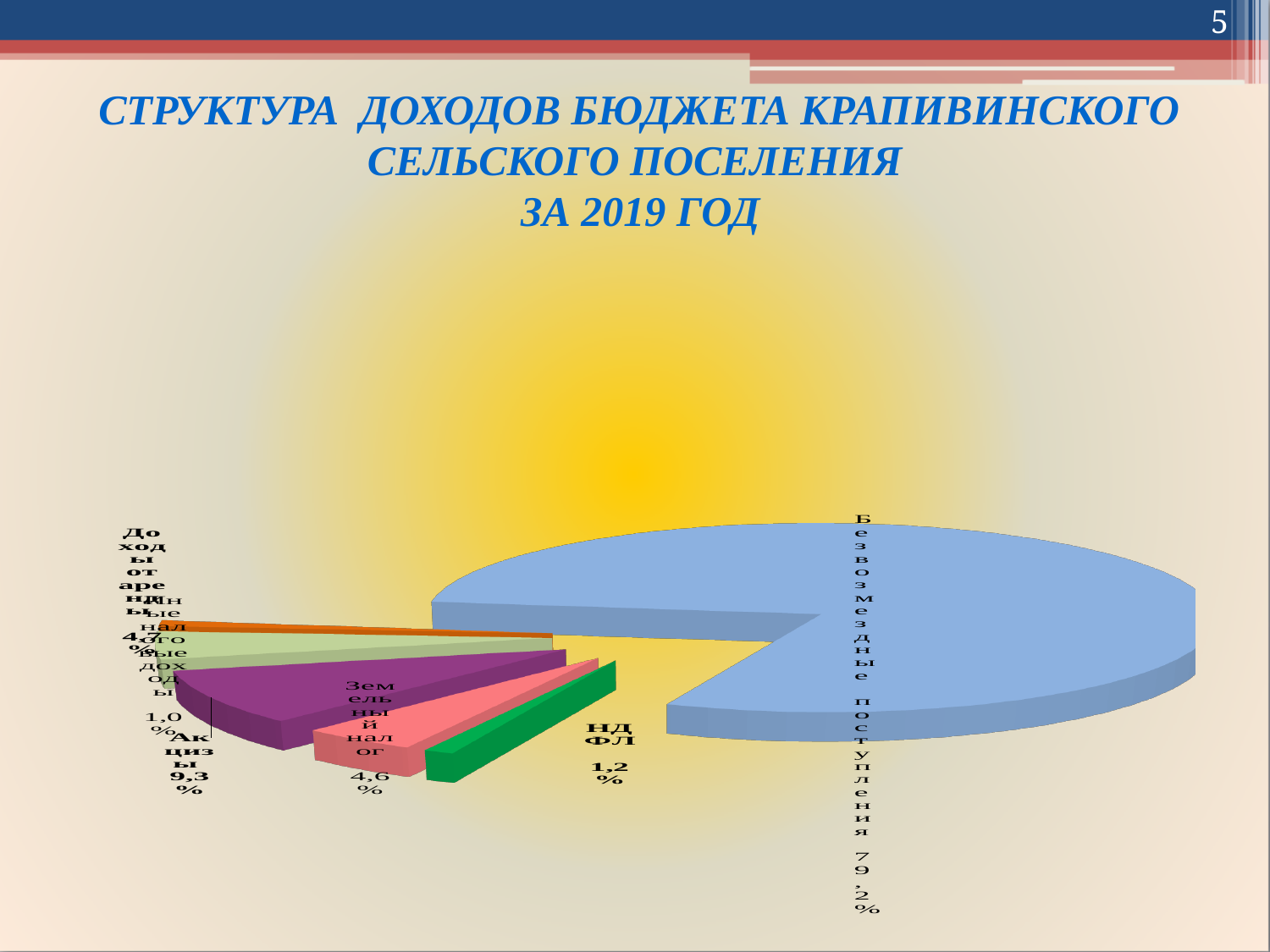
What share of the budget revenue is Земельный налог? 4,6% Which category has the largest share of the pie? Безвозмездные поступления Which is larger, the share for Земельный налог or the share for НДФЛ? Земельный налог What share of the budget revenue is Безвозмездные поступления? 79,2% What share of the budget revenue is НДФЛ? 1,2% What share of the budget revenue is Акцизы? 9,3% By how many percentage points does the share for Акцизы exceed the share for Земельный налог? 4,7 How many slices does the pie chart have? 6 Which is larger, the share for Акцизы or the share for Земельный налог? Акцизы For which year does the chart show the budget revenue structure? 2019 By how many percentage points does the share for Безвозмездные поступления exceed the share for Акцизы? 69,9 What kind of chart is shown on the slide? pie chart